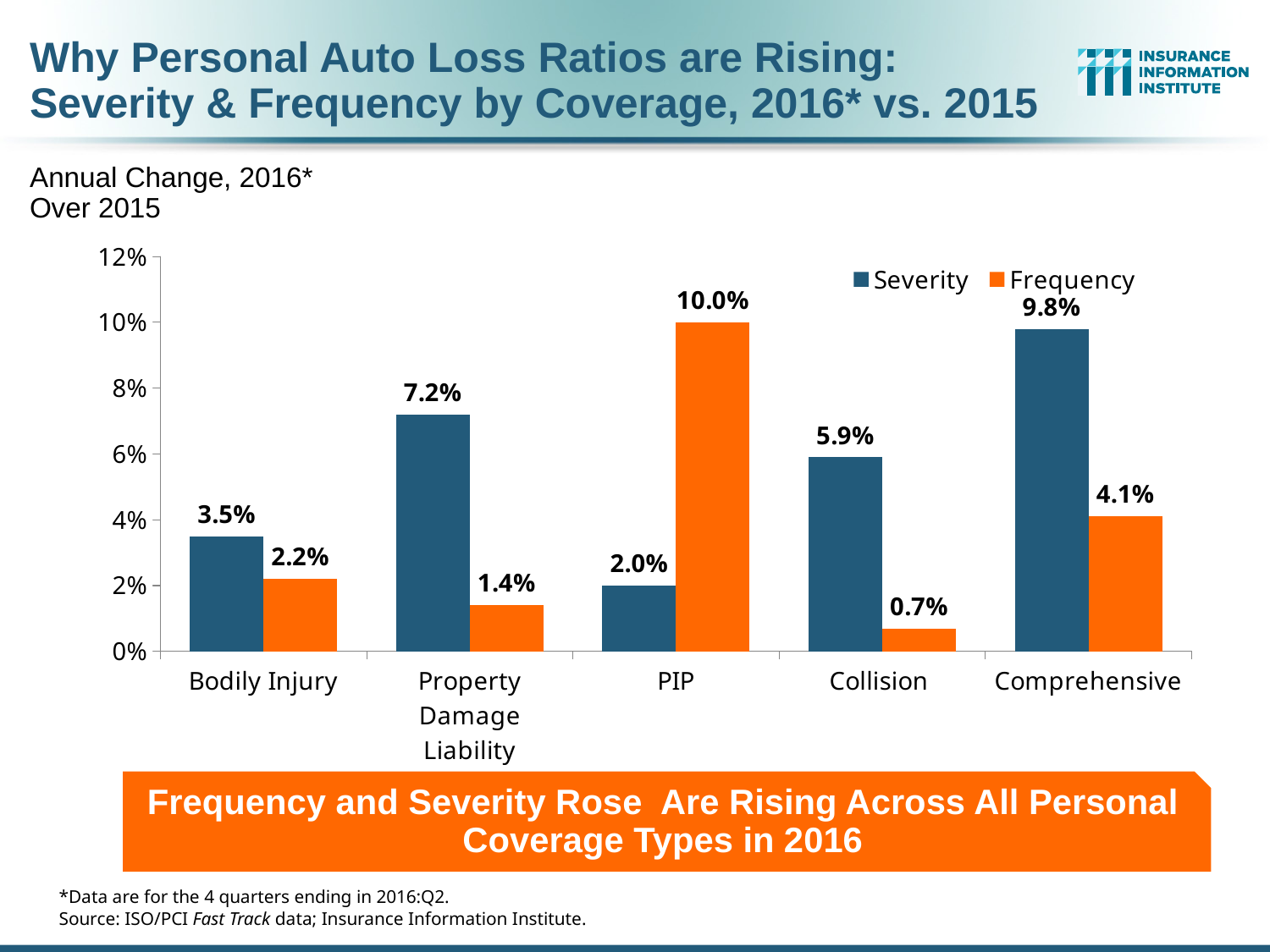
How many series does the legend list? 2 What is the Severity value for Comprehensive? 9.8% What is the Frequency value for PIP? 10.0% How many coverage types are shown on the x axis? 5 Which is larger for Bodily Injury, Severity or Frequency? Severity Is the Severity value for Collision greater or less than 4%? greater Which coverage type has the lowest Frequency value? Collision What is the Severity value for Property Damage Liability? 7.2% Which coverage type has the highest Severity value? Comprehensive What kind of chart is shown on the slide? Bar chart What is the Frequency value for Collision? 0.7% What is the difference between the Frequency and Severity values for PIP? 8.0%